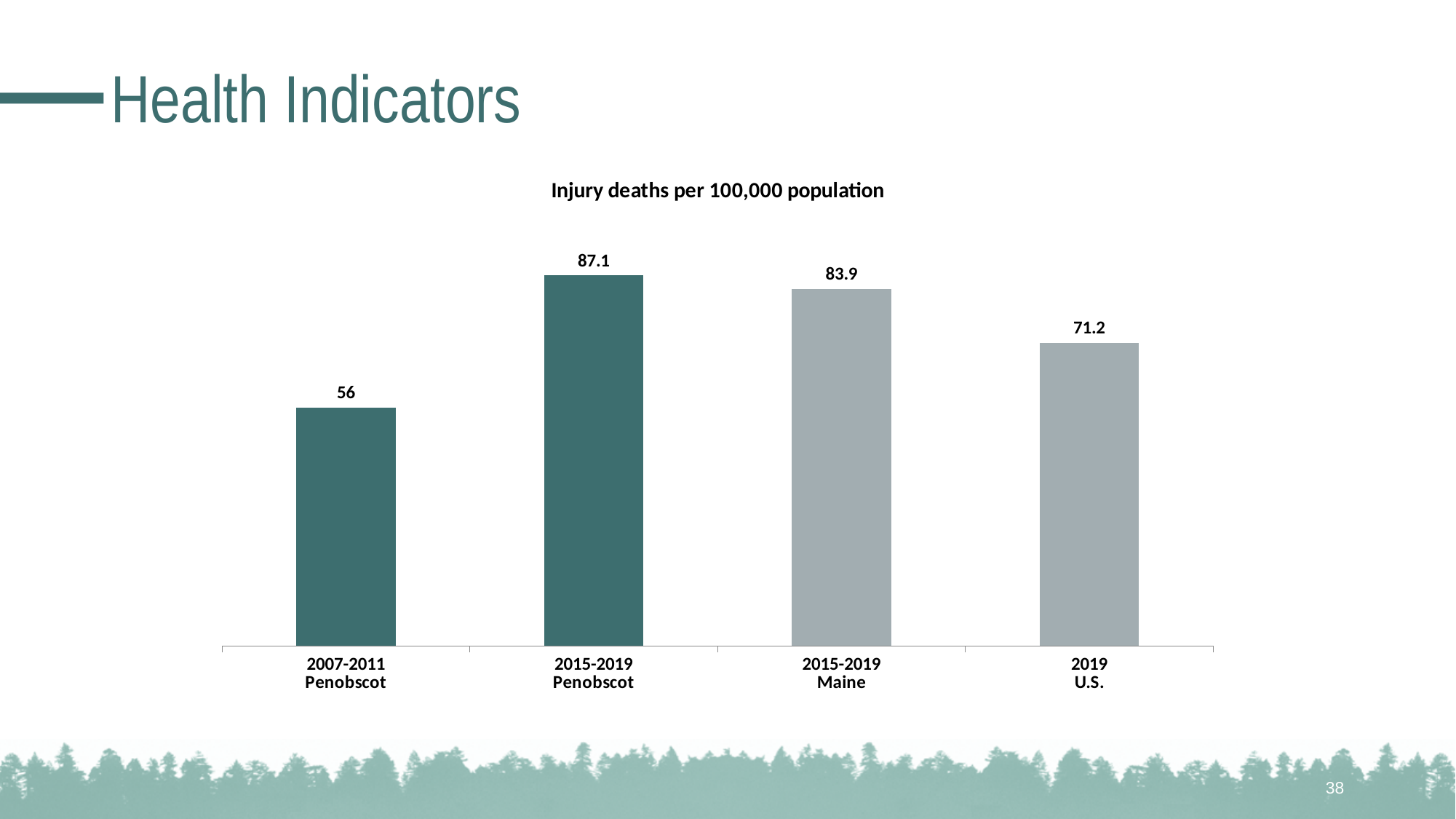
What is the title of the chart? Injury deaths per 100,000 population What is the value for 2015-2019 Penobscot? 87.1 Which category has the highest value? 2015-2019 Penobscot What is the value for 2015-2019 Maine? 83.9 What kind of chart is shown on the slide? Bar chart How many categories are shown in the chart? 4 What is the value for 2007-2011 Penobscot? 56 What is the difference between the 2015-2019 Penobscot value and the 2007-2011 Penobscot value? 31.1 What is the difference between the 2015-2019 Maine value and the 2019 U.S. value? 12.7 What is the value for 2019 U.S.? 71.2 Which category has the lowest value? 2007-2011 Penobscot Which is larger, the value for 2015-2019 Penobscot or the value for 2015-2019 Maine? 2015-2019 Penobscot